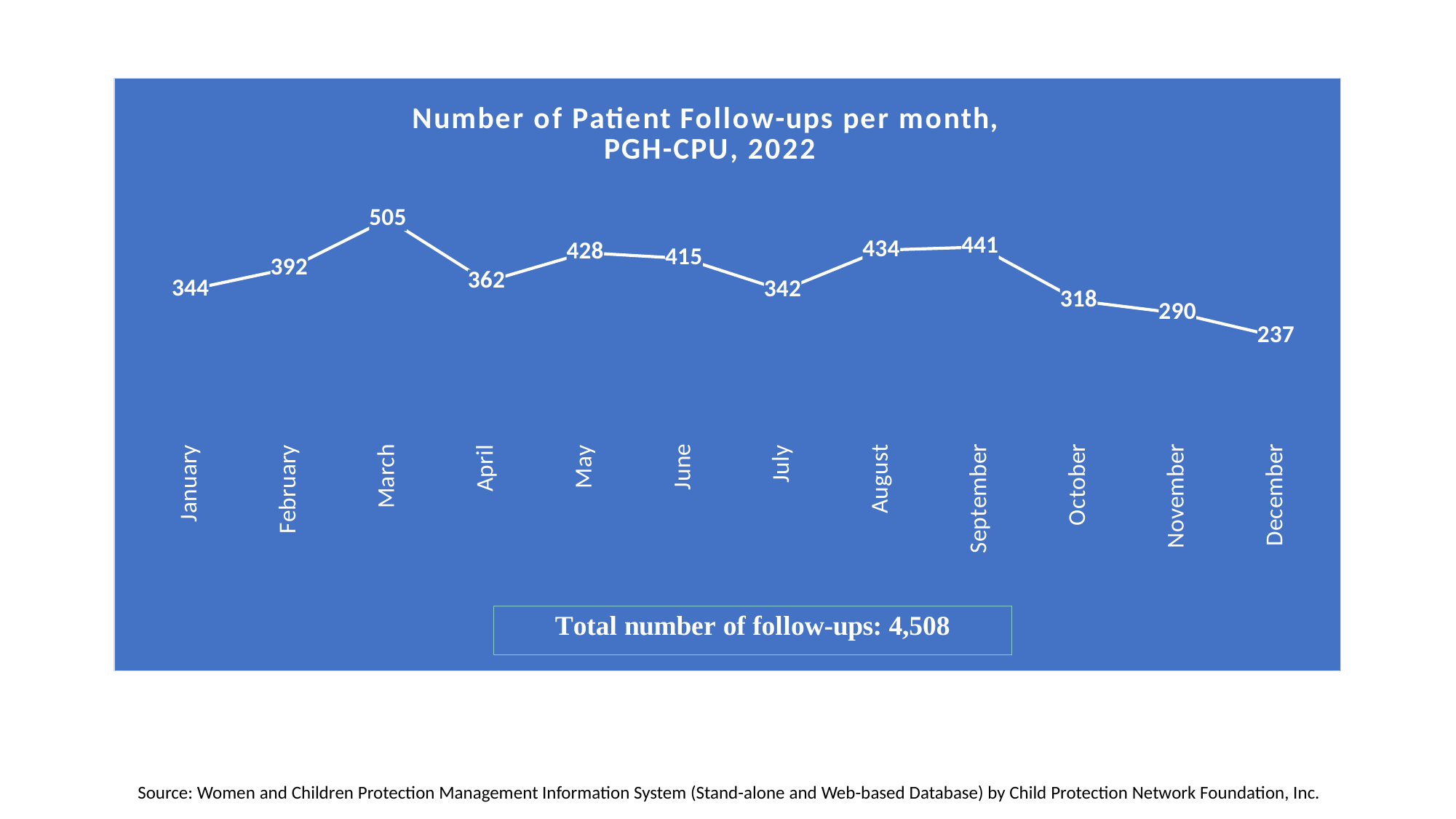
How many months are plotted on the chart? 12 Which month has more patient follow-ups, January or July? January What is the number of patient follow-ups in March? 505 What is the difference between the number of follow-ups in September and in October? 123 Which month has the lowest number of patient follow-ups? December Which month has more patient follow-ups, May or June? May What is the number of patient follow-ups in August? 434 Do the values rise or fall from September to December? Fall What is the difference between the number of follow-ups in March and in April? 143 Which month has the highest number of patient follow-ups? March What is the number of patient follow-ups in December? 237 What kind of chart is shown on the slide? Line chart